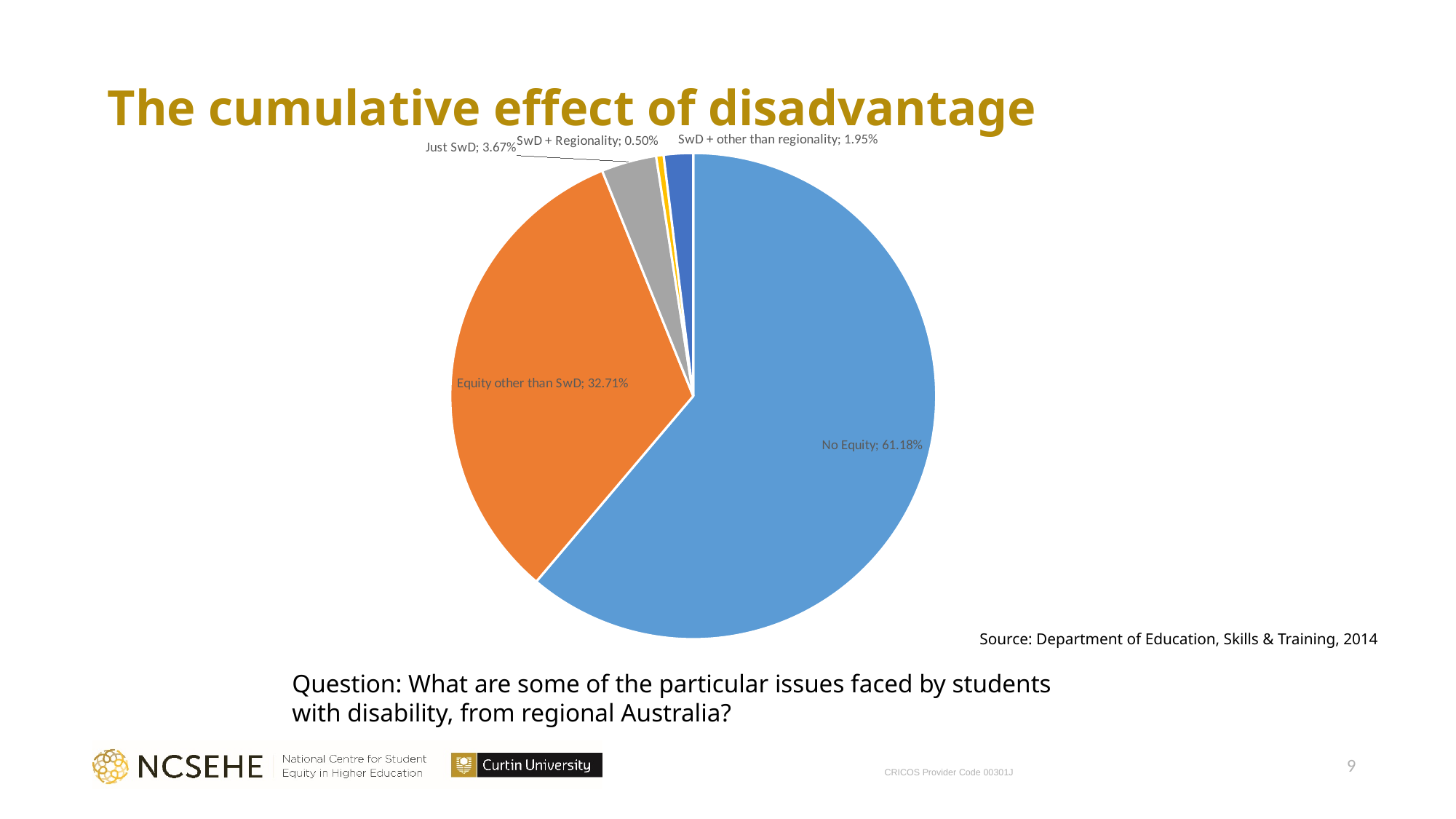
What is the title of the slide containing the pie chart? The cumulative effect of disadvantage How many slices does the pie chart have? 5 What percentage is shown for "SwD + other than regionality"? 1.95% Which is larger, the share for "Just SwD" or the share for "SwD + other than regionality"? Just SwD Which slice of the pie is the largest? No Equity What type of chart is shown on the slide? pie chart What percentage is shown for "Just SwD"? 3.67% Which slice of the pie is the smallest? SwD + Regionality What is the difference in percentage points between "No Equity" and "Equity other than SwD"? 28.47 What percentage is shown for "SwD + Regionality"? 0.50% What share of the pie is labelled "No Equity"? 61.18% What percentage is shown for "Equity other than SwD"? 32.71%